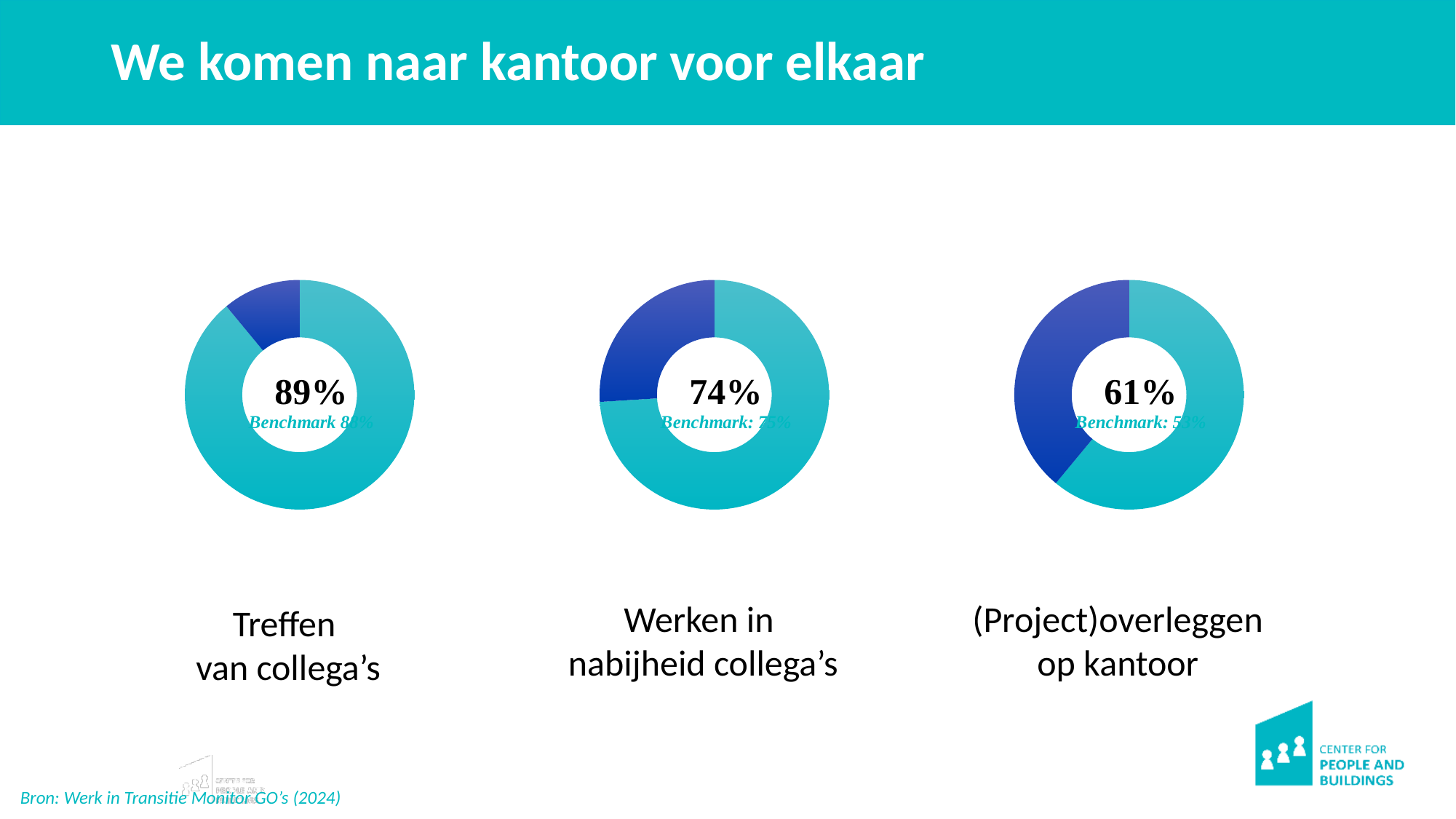
How many donut charts are shown on the slide? 3 Which of the three donut charts shows the highest percentage? Treffen van collega's Which of the three donut charts shows the lowest percentage? (Project)overleggen op kantoor What is the difference between the percentage for 'Treffen van collega's' and the percentage for '(Project)overleggen op kantoor'? 28% What is the difference between the percentage for 'Werken in nabijheid collega's' and the percentage for '(Project)overleggen op kantoor'? 13% What percentage is shown in the centre of the 'Werken in nabijheid collega's' donut chart? 74% What percentage is shown in the centre of the '(Project)overleggen op kantoor' donut chart? 61% In the '(Project)overleggen op kantoor' donut chart, what share of the ring is filled by the light teal segment? 61% Which is larger: the percentage for 'Werken in nabijheid collega's' or for '(Project)overleggen op kantoor'? Werken in nabijheid collega's What is the title of the slide? We komen naar kantoor voor elkaar What kind of chart is used to show the percentages on this slide? Donut (pie) chart What percentage is shown in the centre of the 'Treffen van collega's' donut chart? 89%